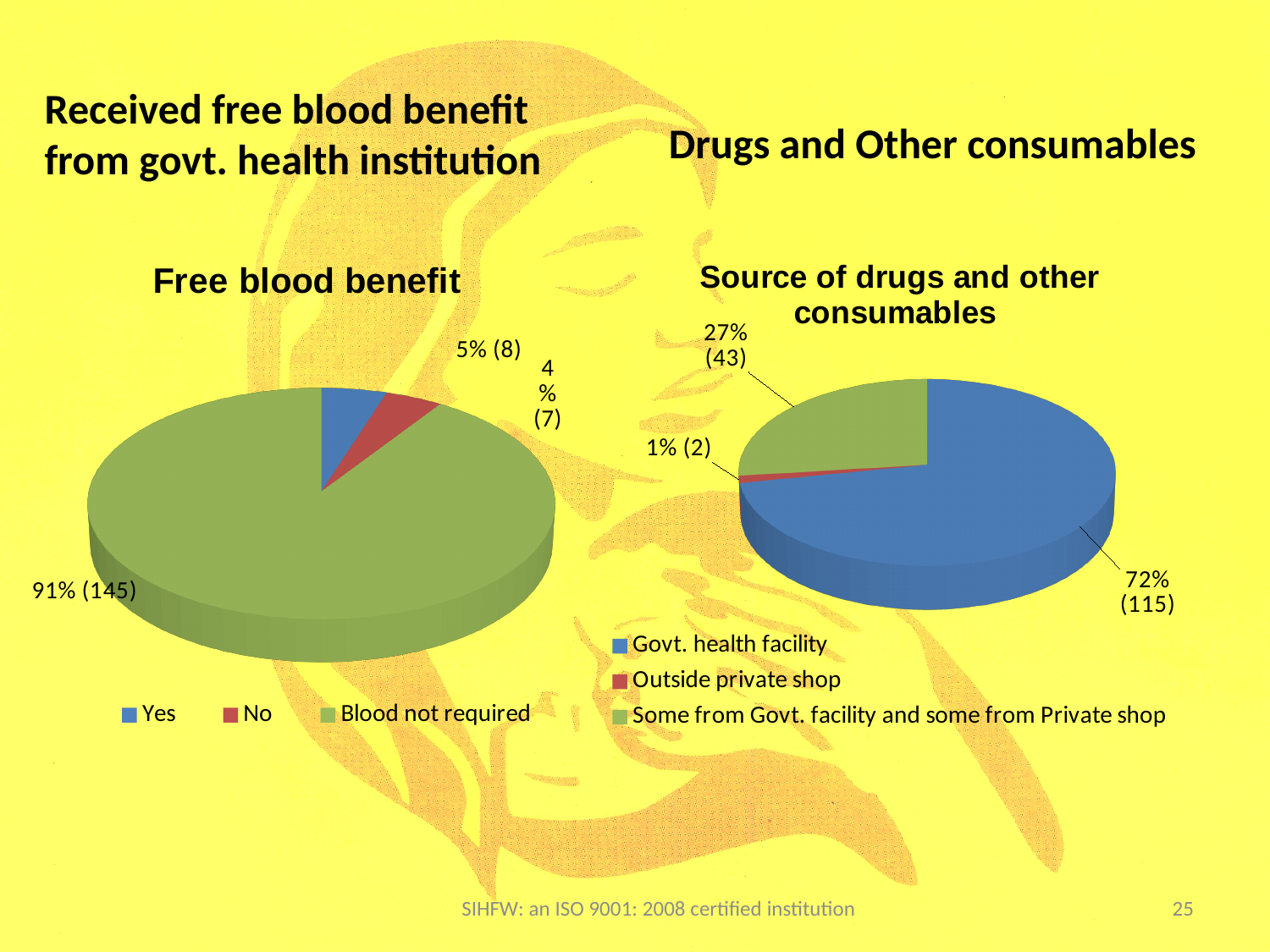
In the 'Source of drugs and other consumables' chart, what share of the pie is 'Outside private shop'? 1% (2) How many categories does the legend of the 'Source of drugs and other consumables' chart list? 3 In the 'Free blood benefit' chart, what colour is the 'Blood not required' slice? green In the 'Source of drugs and other consumables' chart, how many more respondents chose 'Govt. health facility' than 'Some from Govt. facility and some from Private shop'? 72 In the 'Source of drugs and other consumables' chart, what share of the pie is 'Some from Govt. facility and some from Private shop'? 27% (43) What kind of chart is the 'Free blood benefit' chart? pie chart In the 'Source of drugs and other consumables' chart, which category has the largest slice? Govt. health facility In the 'Free blood benefit' chart, what share of the pie is 'Blood not required'? 91% (145) In the 'Free blood benefit' chart, which category has the largest slice? Blood not required How many categories does the legend of the 'Free blood benefit' chart list? 3 In the 'Source of drugs and other consumables' chart, which category has the smallest slice? Outside private shop